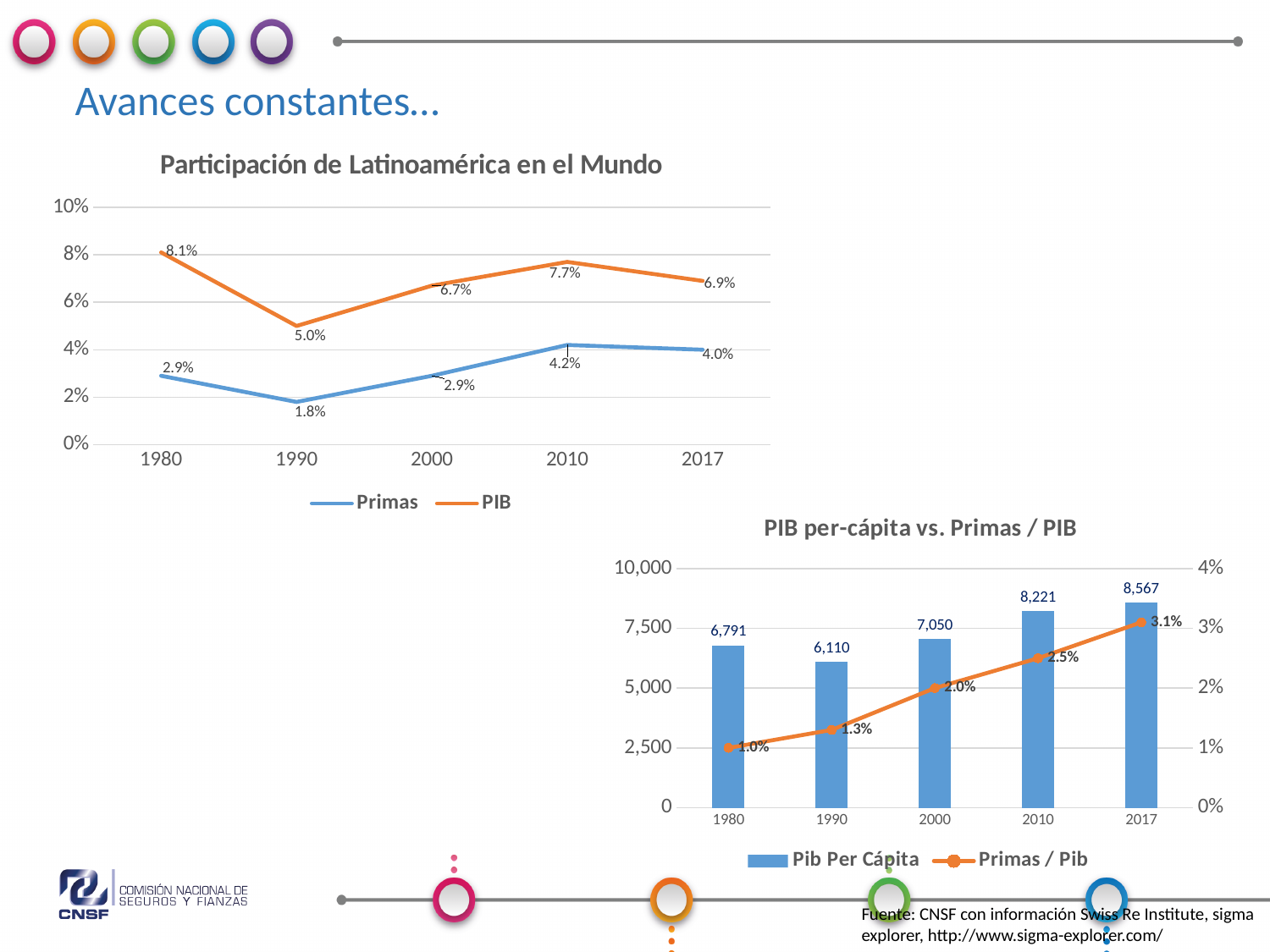
In the chart 'PIB per-cápita vs. Primas / PIB', what is the value of Pib Per Cápita in 2000? 7,050 In the chart 'PIB per-cápita vs. Primas / PIB', how many years are shown on the x axis? 5 In the chart 'Participación de Latinoamérica en el Mundo', what is the value of PIB in 1990? 5.0% In the chart 'Participación de Latinoamérica en el Mundo', in which year is Primas lowest? 1990 In the chart 'Participación de Latinoamérica en el Mundo', in which year is PIB highest? 1980 In the chart 'Participación de Latinoamérica en el Mundo', what is the difference between PIB and Primas in 2017? 2.9% In the chart 'PIB per-cápita vs. Primas / PIB', in which year is Pib Per Cápita lowest? 1990 In the chart 'PIB per-cápita vs. Primas / PIB', what is the value of Primas / Pib in 2017? 3.1% In the chart 'Participación de Latinoamérica en el Mundo', how many series does the legend list? 2 In the chart 'PIB per-cápita vs. Primas / PIB', what is the difference in Pib Per Cápita between 2017 and 2010? 346 In the chart 'Participación de Latinoamérica en el Mundo', what is the value of Primas in 2010? 4.2% In the chart 'PIB per-cápita vs. Primas / PIB', does Primas / Pib rise or fall from 1980 to 2017? rise